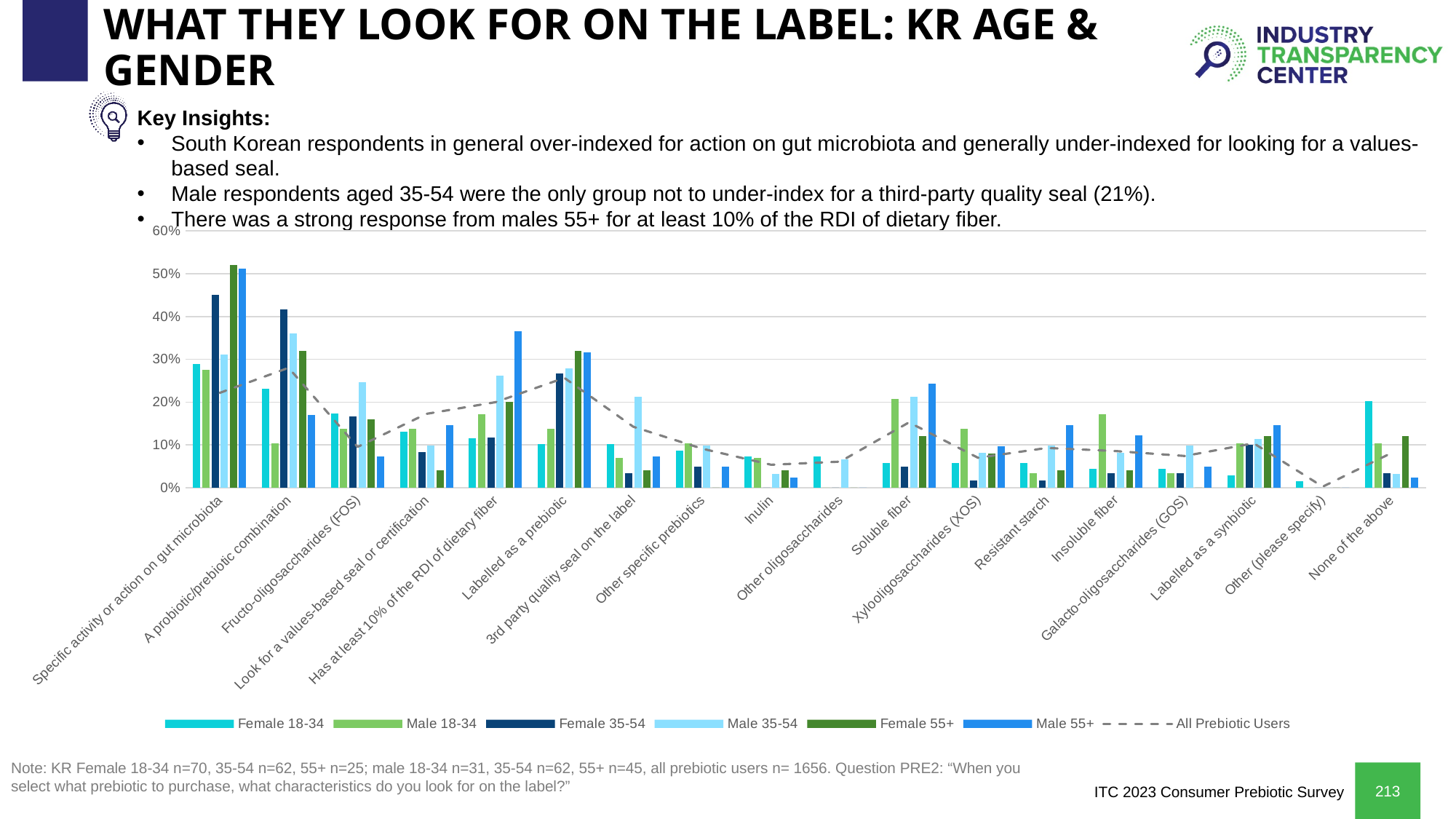
Is the value for Female 35-54 on 'A probiotic/prebiotic combination' greater or less than 40%? greater Which category has the highest value for Male 55+? Specific activity or action on gut microbiota What kind of chart is shown on the slide? combination bar and line chart Which series is represented by the dashed line in the chart? All Prebiotic Users Is the value for Female 18-34 on 'None of the above' greater or less than 10%? greater How many categories are shown along the x axis of the chart? 18 On 'Has at least 10% of the RDI of dietary fiber', which is larger: Male 55+ or Female 55+? Male 55+ Is the value for Female 55+ on 'Specific activity or action on gut microbiota' greater or less than 50%? greater How many entries does the chart's legend list? 8 Which category has the lowest value for Female 18-34? Other (please specify)